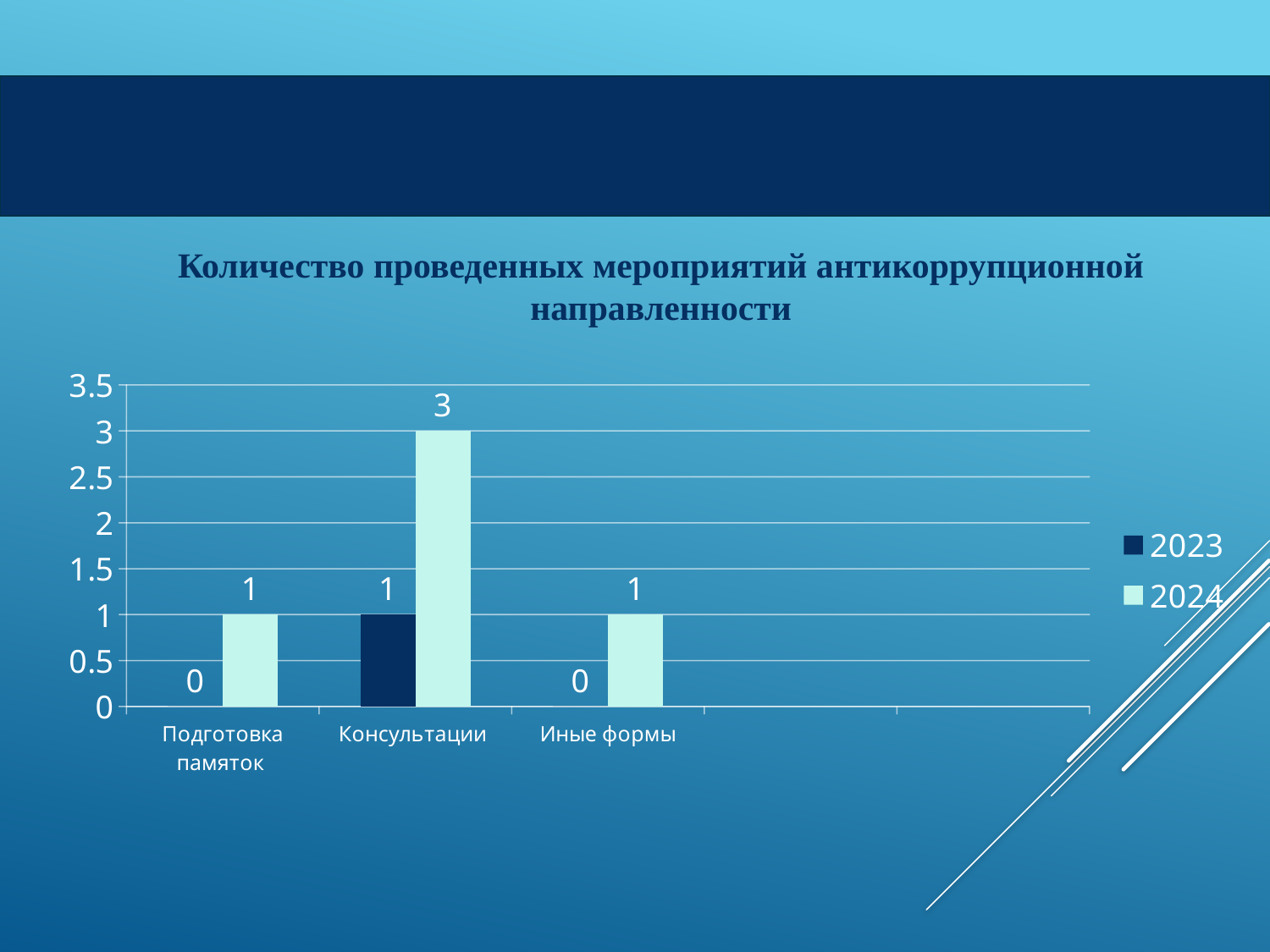
What is the value for Консультации in the 2024 series? 3 How many labeled categories are shown on the x axis? 3 What is the value for Подготовка памяток in the 2023 series? 0 What is the title of the chart? Количество проведенных мероприятий антикоррупционной направленности What kind of chart is shown on the slide? bar chart Which category has the highest value in the 2024 series? Консультации What is the difference between the 2024 and 2023 values for Консультации? 2 How many series does the legend list? 2 What is the value for Иные формы in the 2024 series? 1 Is the 2024 value for Консультации greater or less than 2? greater Which is larger for Иные формы: the 2023 value or the 2024 value? 2024 What is the value for Консультации in the 2023 series? 1